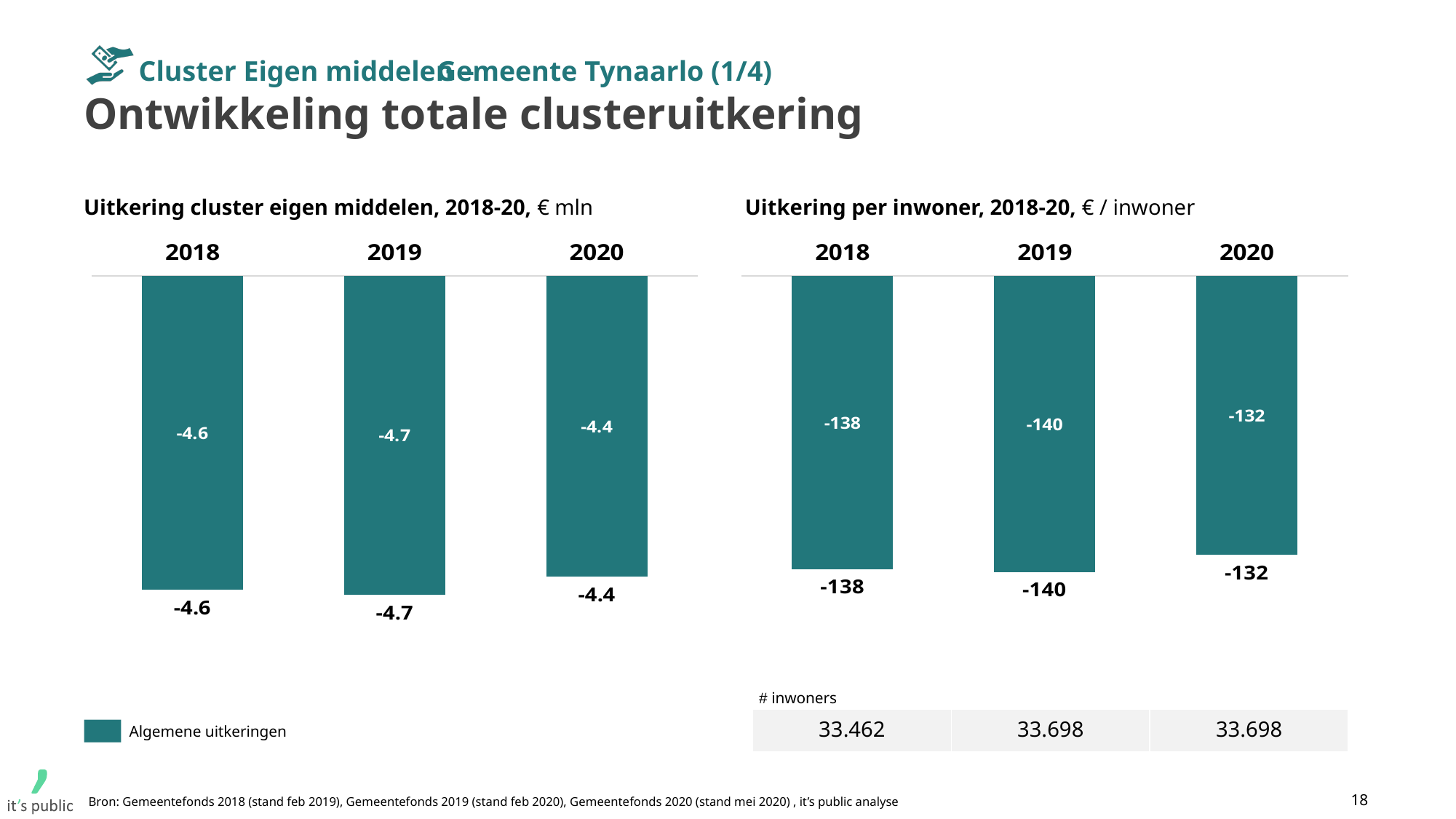
In the chart 'Uitkering cluster eigen middelen, 2018-20', what is the value for 2019? -4.7 How many years are shown in the chart 'Uitkering per inwoner, 2018-20'? 3 What type of chart is 'Uitkering cluster eigen middelen, 2018-20'? Bar chart In the chart 'Uitkering per inwoner, 2018-20', what is the value for 2018? -138 In the chart 'Uitkering cluster eigen middelen, 2018-20', which year has the lowest (most negative) value? 2019 What series name does the legend on the left chart show? Algemene uitkeringen In the chart 'Uitkering per inwoner, 2018-20', which year has the highest (least negative) value? 2020 In the chart 'Uitkering per inwoner, 2018-20', what is the difference between the 2019 value and the 2020 value? 8 In the chart 'Uitkering per inwoner, 2018-20', what is the value for 2020? -132 In the chart 'Uitkering cluster eigen middelen, 2018-20', what is the value for 2020? -4.4 In the chart 'Uitkering cluster eigen middelen, 2018-20', is the value for 2018 or 2020 more negative? 2018 In the '# inwoners' table below the right chart, what is the number of inhabitants for 2018? 33.462